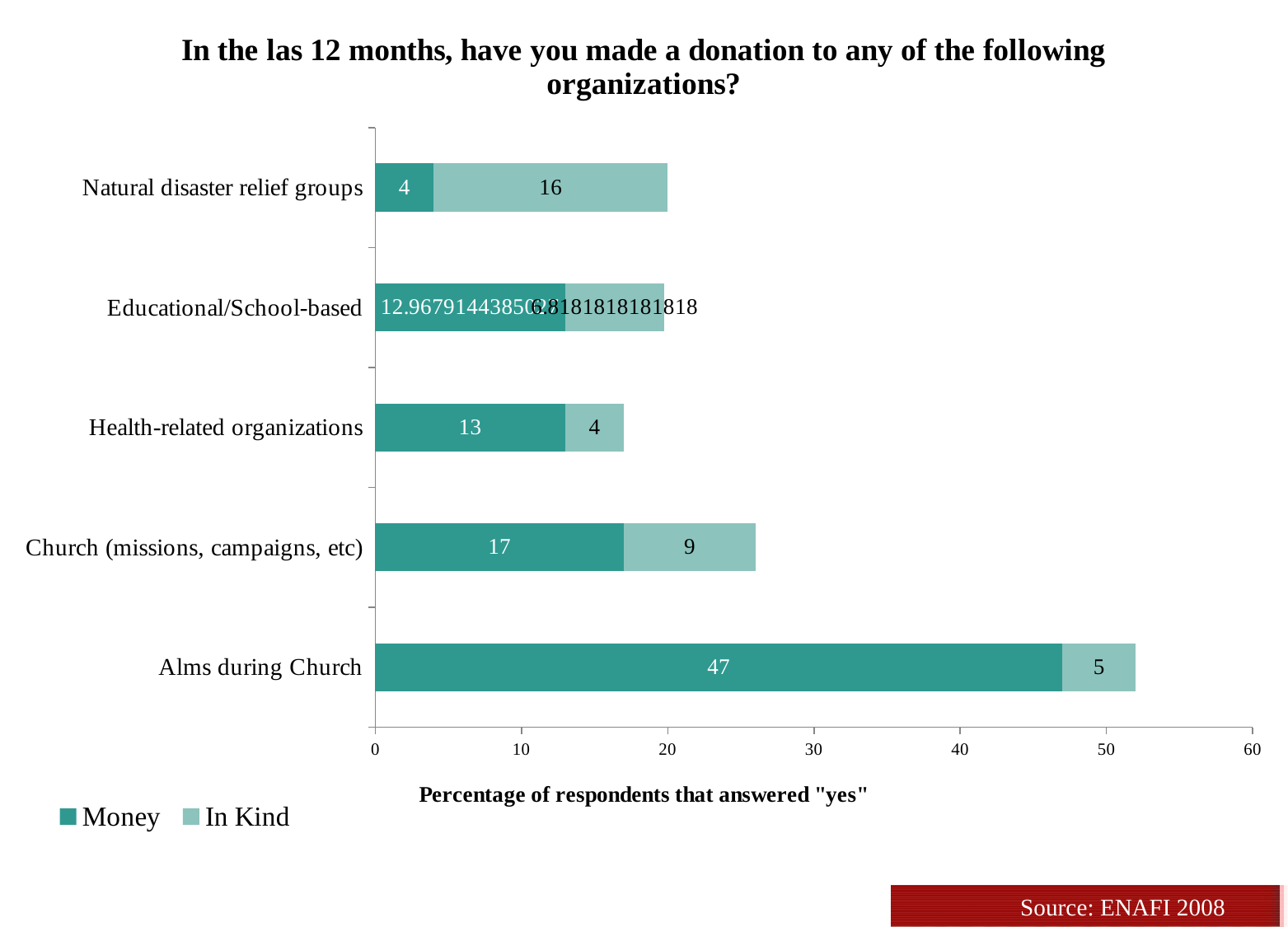
How many organization categories are shown on the chart? 5 What is the In Kind value for Church (missions, campaigns, etc)? 9 What is the difference between the Money value for Church (missions, campaigns, etc) and the Money value for Health-related organizations? 4 Is the Money value for Educational/School-based greater or less than 10? greater Which category has the highest Money value? Alms during Church What is the Money value for Alms during Church? 47 Which is larger: the In Kind value for Natural disaster relief groups or the In Kind value for Alms during Church? Natural disaster relief groups Which category has the lowest Money value? Natural disaster relief groups What is the In Kind value for Natural disaster relief groups? 16 What type of chart is shown on the slide? Stacked bar chart What is the total of the stacked bar for Church (missions, campaigns, etc)? 26 How many series does the legend list? 2